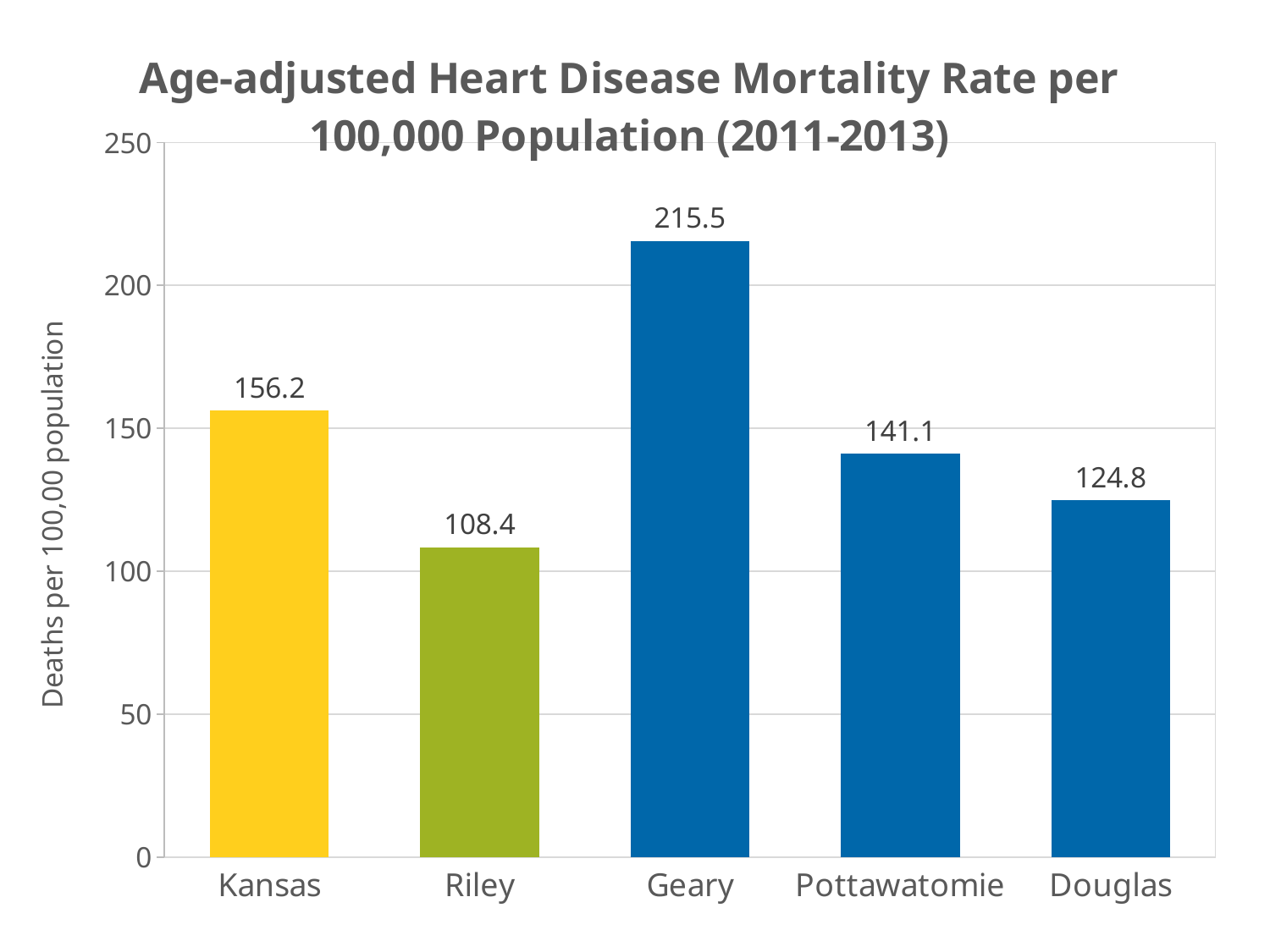
Which has a higher heart disease mortality rate, Kansas or Douglas? Kansas What is the age-adjusted heart disease mortality rate for Pottawatomie? 141.1 What is the label of the vertical axis? Deaths per 100,00 population What kind of chart is shown on the slide? Bar chart What is the difference between the mortality rates for Pottawatomie and Douglas? 16.3 Which category has the lowest heart disease mortality rate? Riley Is the value for Geary greater or less than 200? greater What is the age-adjusted heart disease mortality rate for Riley? 108.4 What is the difference between the mortality rates for Geary and Kansas? 59.3 What is the age-adjusted heart disease mortality rate for Kansas? 156.2 Which category has the highest heart disease mortality rate? Geary How many categories are shown on the x axis? 5